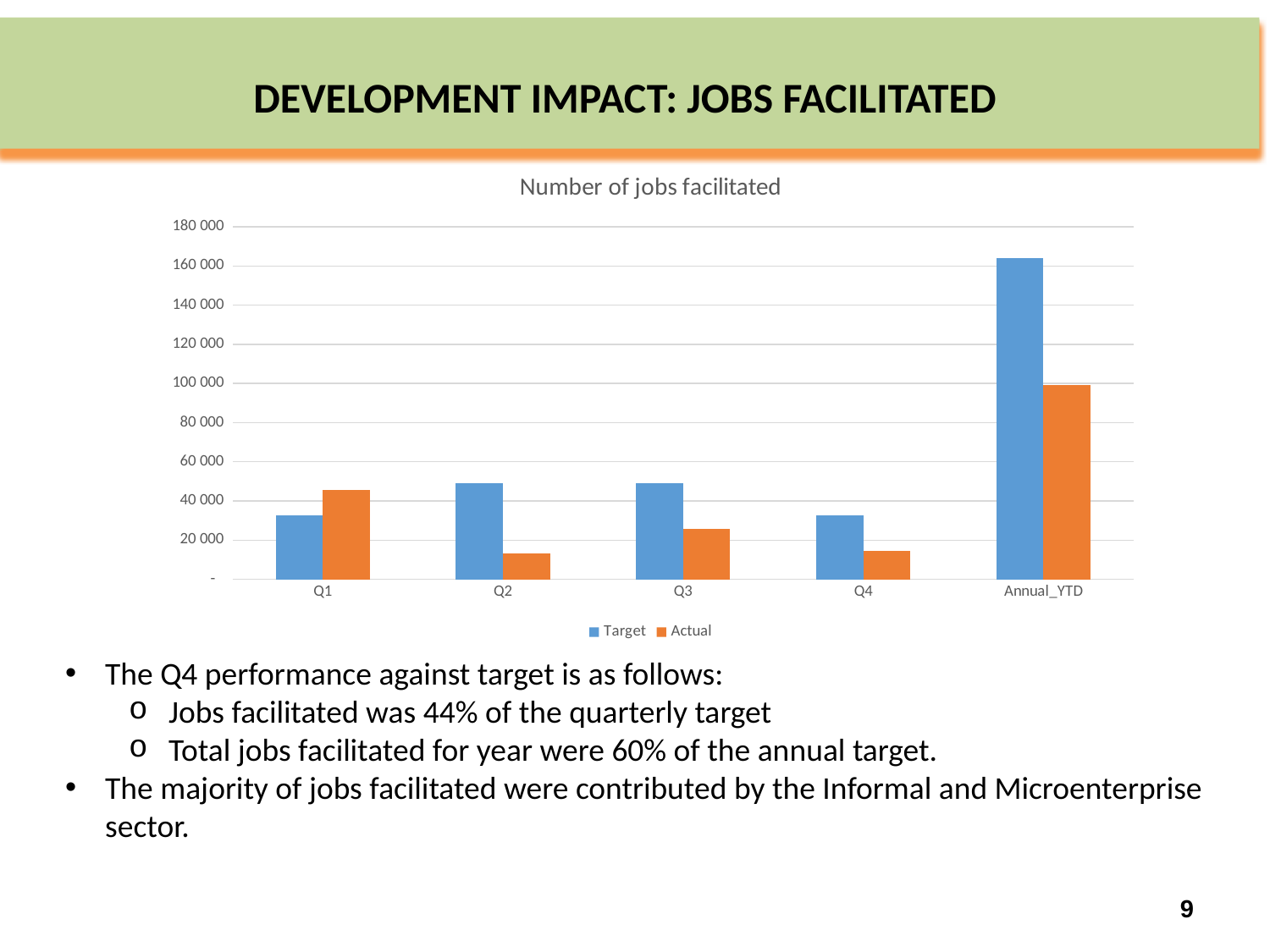
Which category has the highest Actual value? Annual_YTD Is the Actual value for Annual_YTD greater or less than 80 000? greater How many categories are shown on the x axis of the chart? 5 Which category has the highest Target value? Annual_YTD What is the title of the chart? Number of jobs facilitated What kind of chart is shown on the slide? Bar chart In Q2, which is larger, the Target or the Actual value? Target Is the Target value for Annual_YTD greater or less than 140 000? greater Is the Target value for Q3 greater or less than 40 000? greater In Q1, which is larger, the Target or the Actual value? Actual How many series does the chart legend list? 2